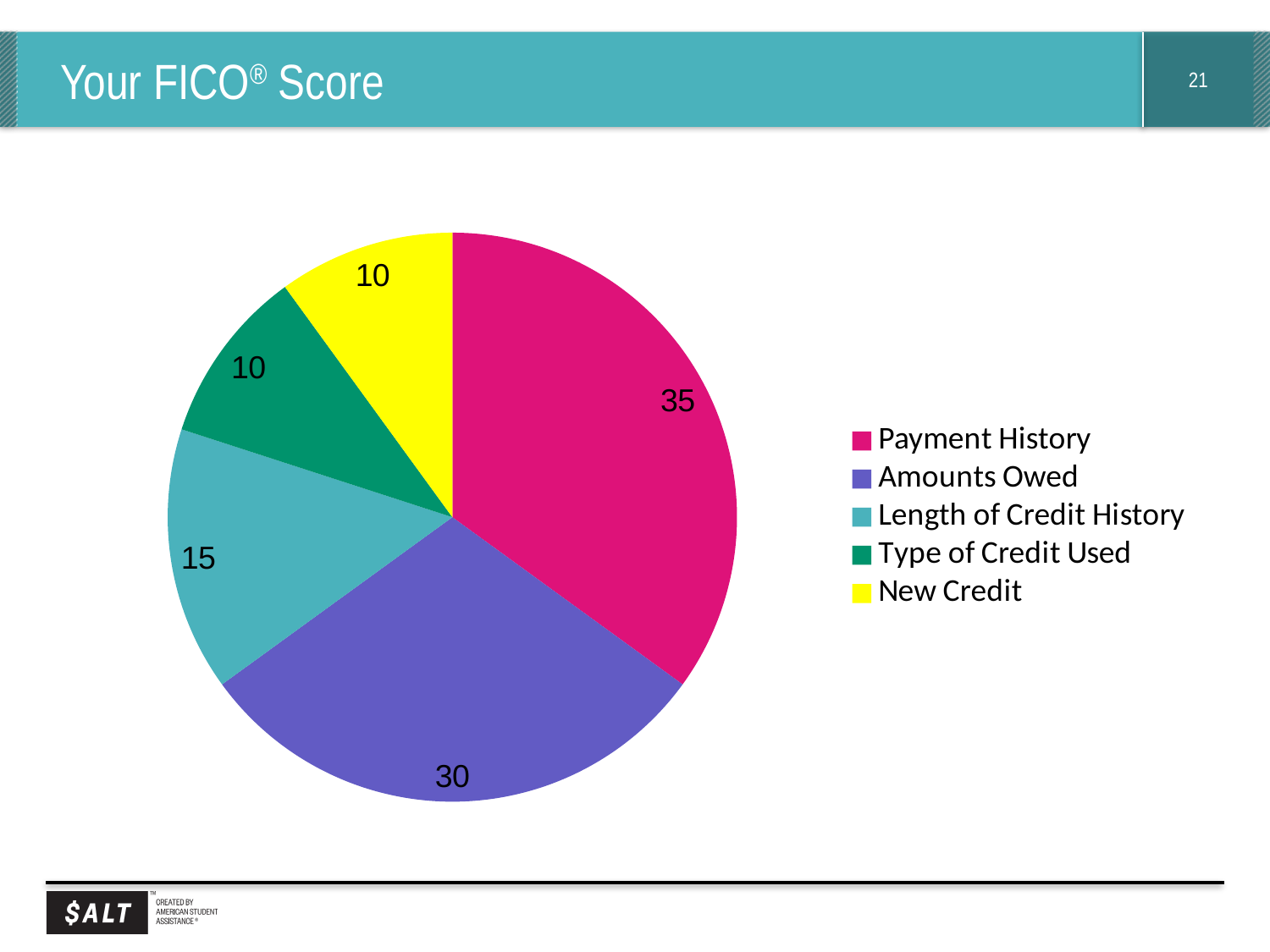
What is the difference between the values for Payment History and Amounts Owed? 5 What colour is the slice for New Credit? yellow What is the total of all the slice values? 100 What is the value for Length of Credit History? 15 What is the value for Payment History? 35 What is the value for Type of Credit Used? 10 What is the value for Amounts Owed? 30 What kind of chart is shown on the slide? pie chart Which category has the largest slice? Payment History How many categories does the pie chart have? 5 What share of the pie does Amounts Owed represent? 30% Which is larger, Length of Credit History or New Credit? Length of Credit History